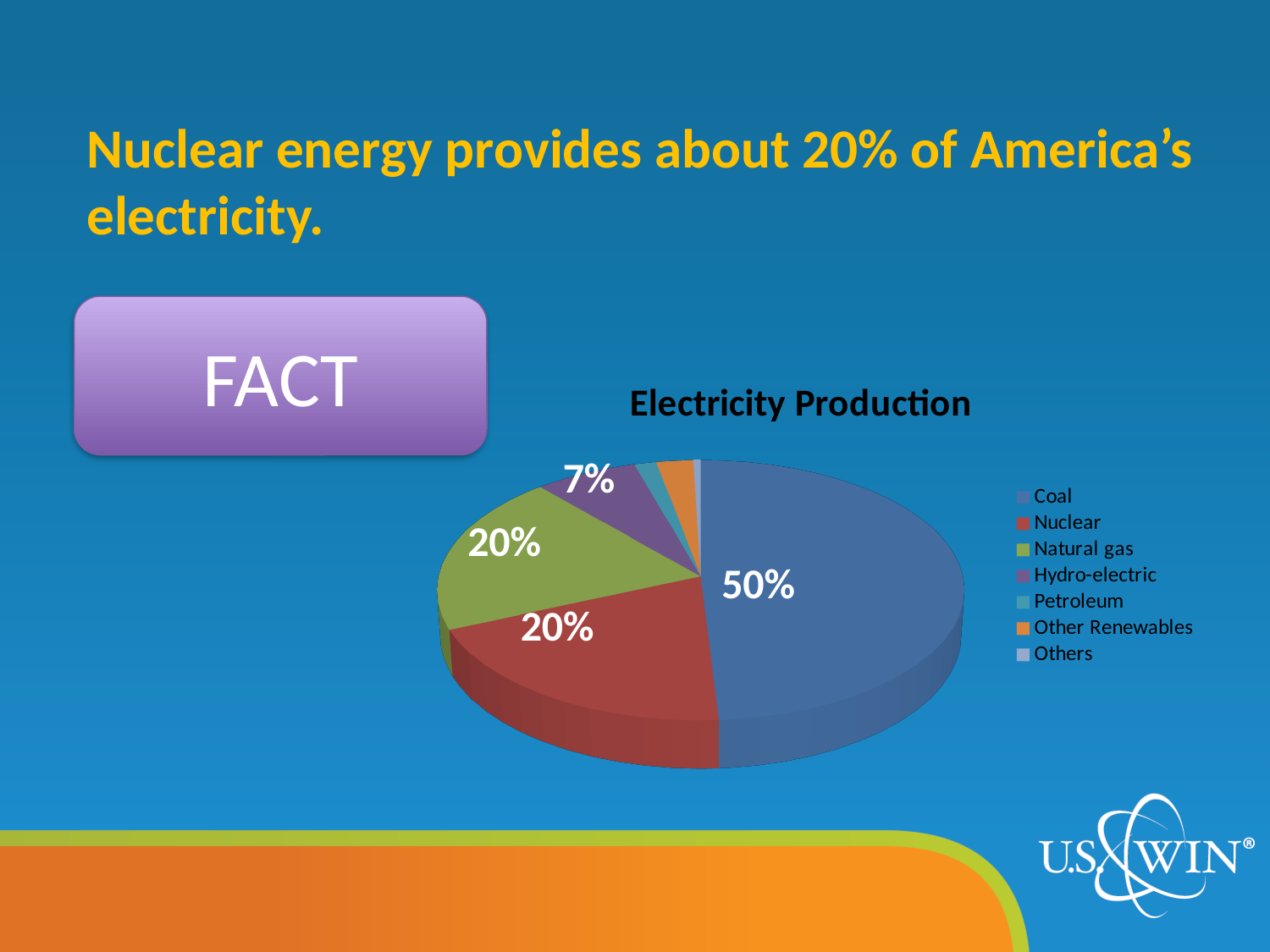
How many categories does the legend list? 7 What share of electricity production does Hydro-electric account for? 7% What kind of chart is shown on the slide? pie chart What colour is the Coal slice? blue Which category has the largest slice of the pie? Coal What share of electricity production does Coal account for? 50% What share of electricity production does Natural gas account for? 20% What share of electricity production does Nuclear account for? 20% What is the chart's title? Electricity Production What is the difference between the Coal share and the Nuclear share? 30% What is the difference between the Nuclear share and the Hydro-electric share? 13% Which is larger, the Coal slice or the Natural gas slice? Coal